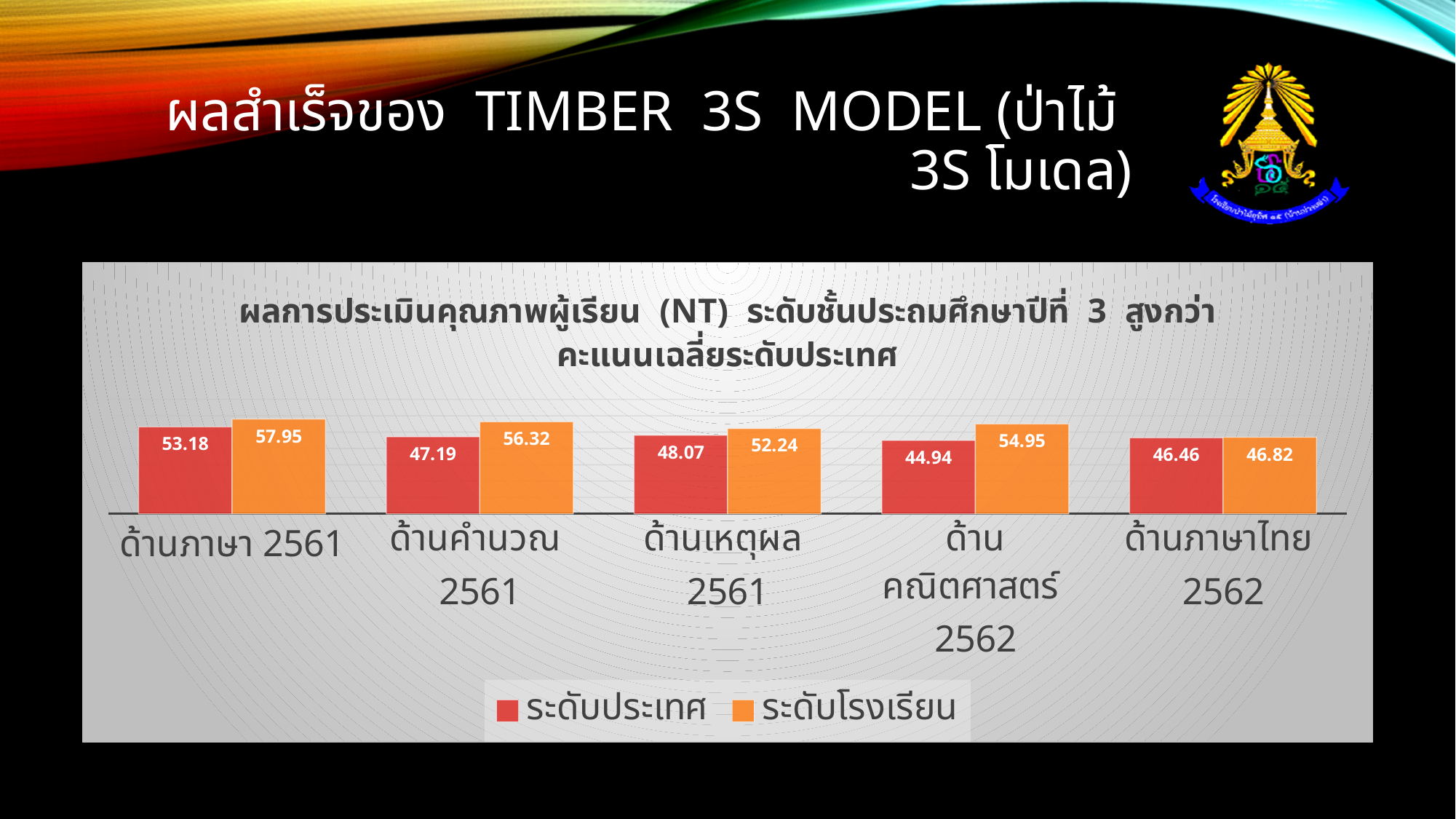
What is the difference between the ระดับโรงเรียน and ระดับประเทศ values for ด้านภาษาไทย 2562? 0.36 How many categories are shown on the x axis? 5 What is the ระดับโรงเรียน value for ด้านภาษา 2561? 57.95 Which category has the highest ระดับโรงเรียน value? ด้านภาษา 2561 What is the ระดับประเทศ value for ด้านคณิตศาสตร์ 2562? 44.94 Which category has the lowest ระดับประเทศ value? ด้านคณิตศาสตร์ 2562 What kind of chart is shown on the slide? Bar chart Which colour represents the ระดับโรงเรียน series? Orange Which is larger for ด้านเหตุผล 2561: the ระดับประเทศ value or the ระดับโรงเรียน value? ระดับโรงเรียน How many series does the legend list? 2 What is the ระดับโรงเรียน value for ด้านคำนวณ 2561? 56.32 What is the difference between the ระดับโรงเรียน and ระดับประเทศ values for ด้านคณิตศาสตร์ 2562? 10.01